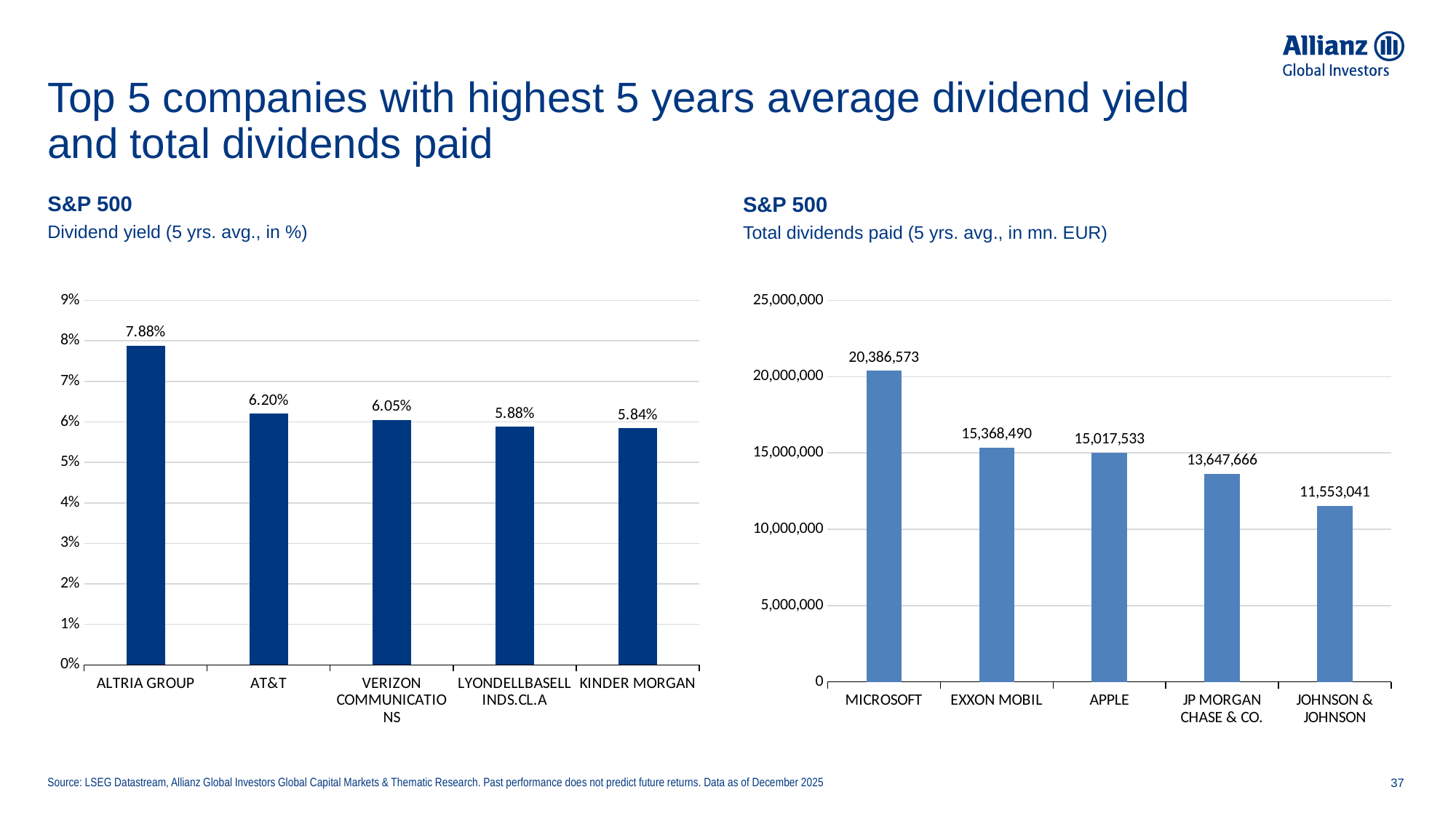
In the Dividend yield chart on the left, what is the difference between the values for ALTRIA GROUP and AT&T? 1.68% In the Dividend yield chart on the left, which company has the lowest dividend yield? KINDER MORGAN In the Total dividends paid chart on the right, which company has the highest value? MICROSOFT In the Total dividends paid chart on the right, what is the value for MICROSOFT? 20,386,573 In the Dividend yield chart on the left, what is the value for ALTRIA GROUP? 7.88% In the Total dividends paid chart on the right, is the value for JOHNSON & JOHNSON greater or less than 10,000,000? greater What kind of chart is the Total dividends paid chart on the right? bar chart In the Total dividends paid chart on the right, what is the difference between the values for EXXON MOBIL and APPLE? 350,957 In the Dividend yield chart on the left, do the values rise or fall from left to right? fall In the Dividend yield chart on the left, what is the value for VERIZON COMMUNICATIONS? 6.05% In the Dividend yield chart on the left, how many companies are shown? 5 In the Total dividends paid chart on the right, what is the value for JP MORGAN CHASE & CO.? 13,647,666